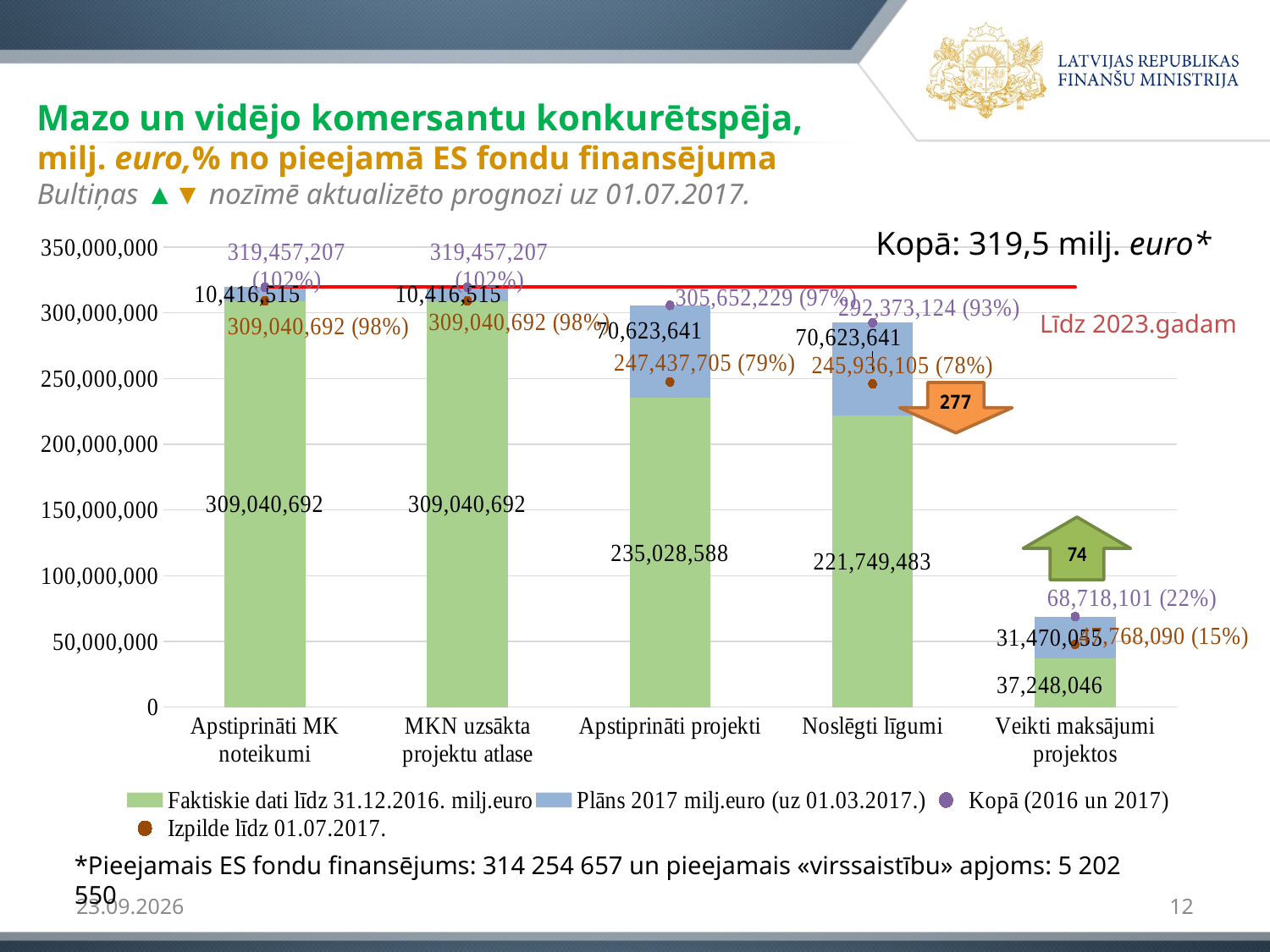
Is the total height of the stacked bar for 'Veikti maksājumi projektos' greater or less than 100,000,000? less What is the value of the 'Plāns 2017 milj.euro (uz 01.03.2017.)' series for 'Noslēgti līgumi'? 70,623,641 What is the value of the 'Faktiskie dati līdz 31.12.2016. milj.euro' series for 'Apstiprināti projekti'? 235,028,588 What kind of chart is shown on the slide? Combination chart: stacked bar chart with line/point markers What is the 'Izpilde līdz 01.07.2017.' value shown for 'Veikti maksājumi projektos'? 47,768,090 (15%) What is the total of the stacked bar for 'Apstiprināti projekti' (green plus blue segments)? 305,652,229 How many series does the legend list? 4 How many categories are shown on the x axis? 5 What is the 'Kopā (2016 un 2017)' value shown for 'Noslēgti līgumi'? 292,373,124 (93%) What is the difference between the 'Faktiskie dati līdz 31.12.2016. milj.euro' values for 'Apstiprināti projekti' and 'Noslēgti līgumi'? 13,279,105 Which category has the lowest value for the 'Faktiskie dati līdz 31.12.2016. milj.euro' series? Veikti maksājumi projektos Which is larger: the 'Faktiskie dati līdz 31.12.2016. milj.euro' value for 'Apstiprināti projekti' or for 'Noslēgti līgumi'? Apstiprināti projekti